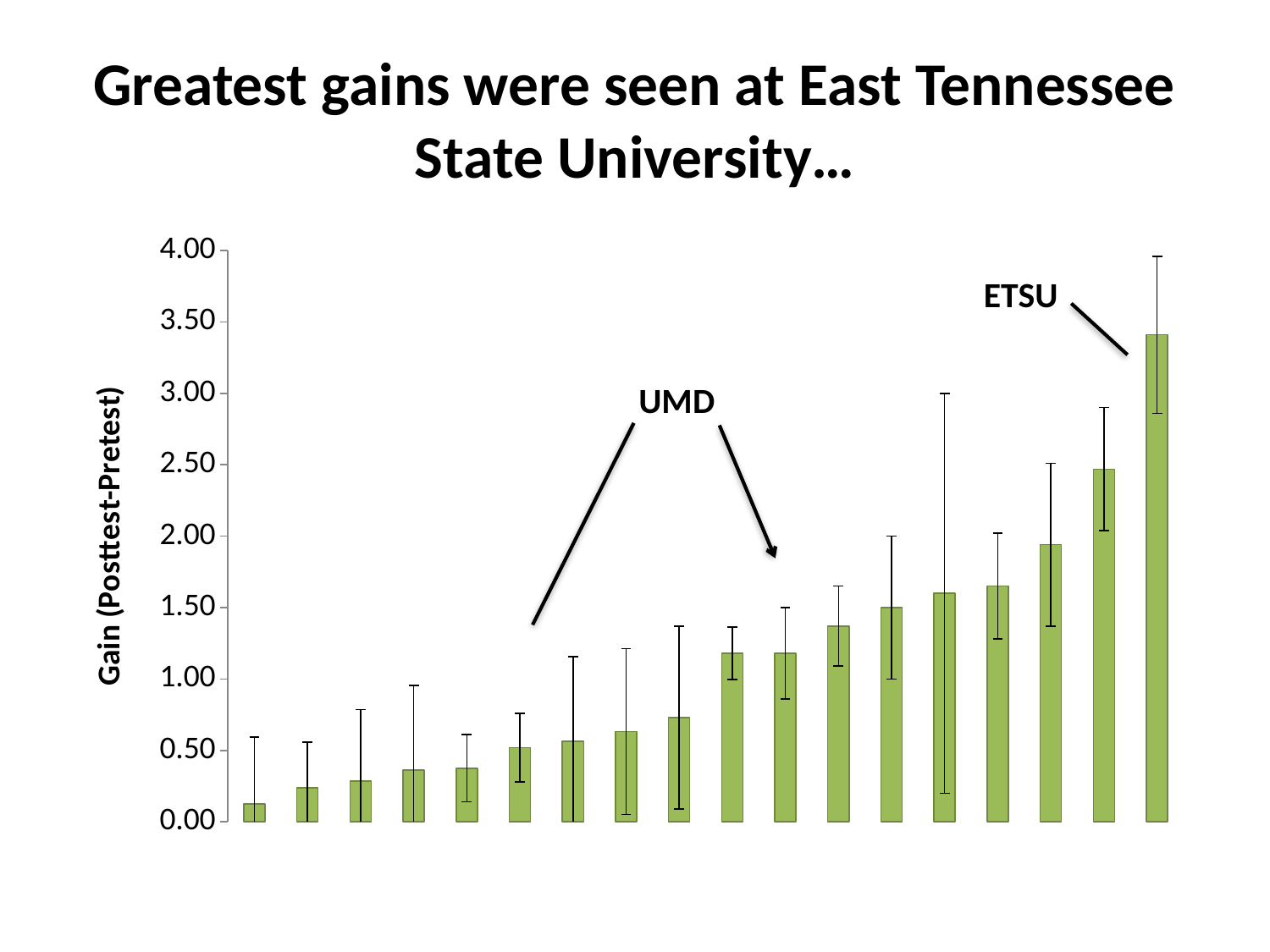
What is the title of the y axis? Gain (Posttest-Pretest) Are the values for the bars labelled UMD greater or less than 1.50? less Which annotated institution has the higher gain, ETSU or UMD? ETSU Is the value for the leftmost bar greater or less than 0.50? less Are the values for the bars labelled UMD greater or less than 1.00? greater What kind of chart is shown on the slide? bar chart How many bars are plotted in the chart? 18 What is the highest tick value shown on the y axis? 4.00 Do the bar values rise or fall from left to right along the x axis? rise Which bar has the highest value in the chart? ETSU (the rightmost bar)